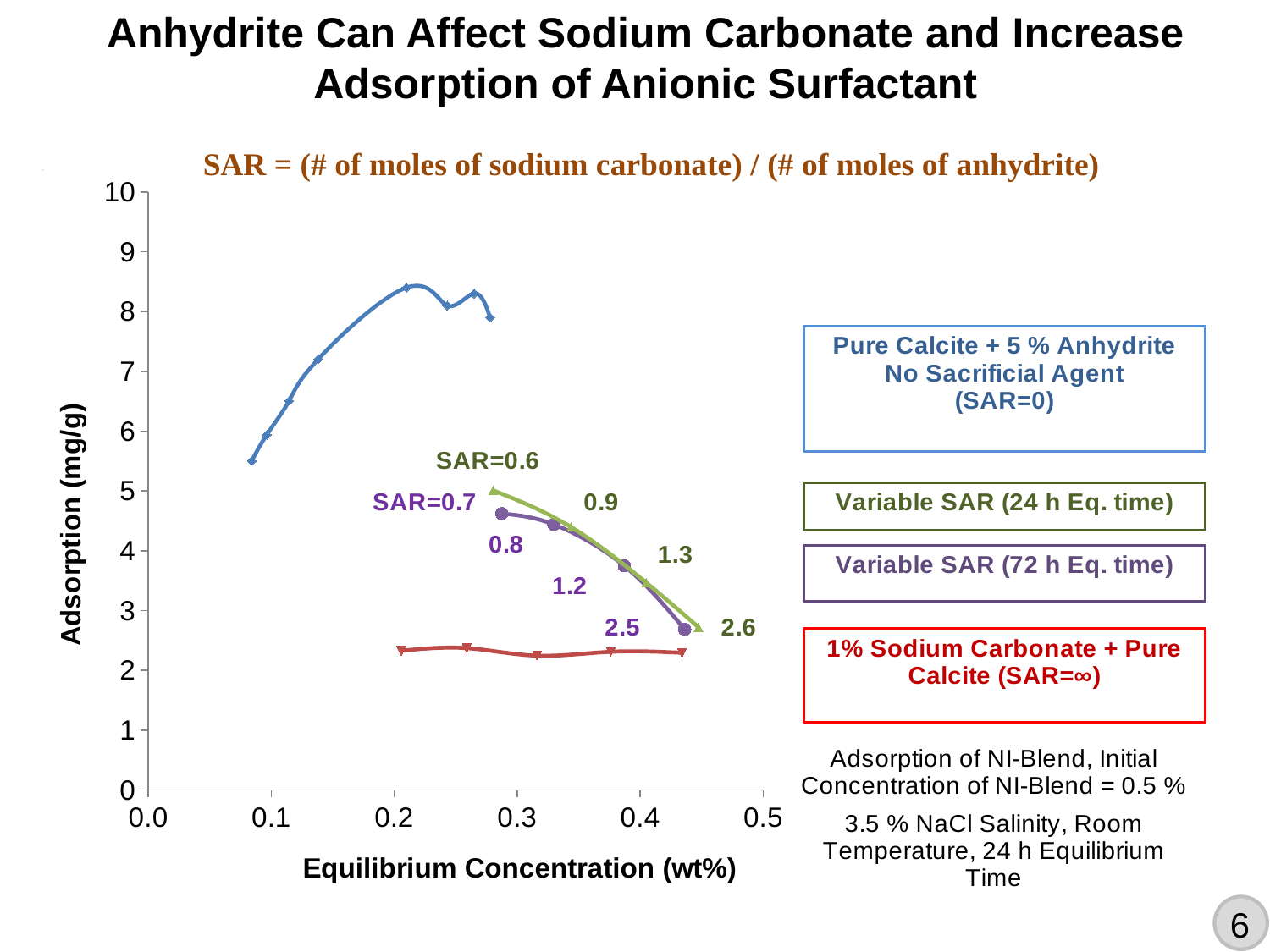
Which series reaches the highest adsorption value on the chart? Pure Calcite + 5 % Anhydrite No Sacrificial Agent (SAR=0) Are the adsorption values of the 1% Sodium Carbonate + Pure Calcite (SAR=∞) series greater or less than 3 mg/g? less How many series are identified in the legend boxes to the right of the chart? 4 Which series has the lowest adsorption values on the chart? 1% Sodium Carbonate + Pure Calcite (SAR=∞) What is the label of the y-axis? Adsorption (mg/g) What is the label of the x-axis? Equilibrium Concentration (wt%) Is the peak adsorption of the Pure Calcite + 5 % Anhydrite (SAR=0) series greater or less than 8 mg/g? greater At an equilibrium concentration of about 0.25 wt%, which series has the larger adsorption: Pure Calcite + 5 % Anhydrite (SAR=0) or 1% Sodium Carbonate + Pure Calcite (SAR=∞)? Pure Calcite + 5 % Anhydrite (SAR=0) Is the adsorption at the SAR=0.6 point of the Variable SAR (24 h Eq. time) series greater or less than 4 mg/g? greater Does adsorption for the Variable SAR (24 h Eq. time) series rise or fall as equilibrium concentration increases? fall What kind of chart is shown on the slide? line chart